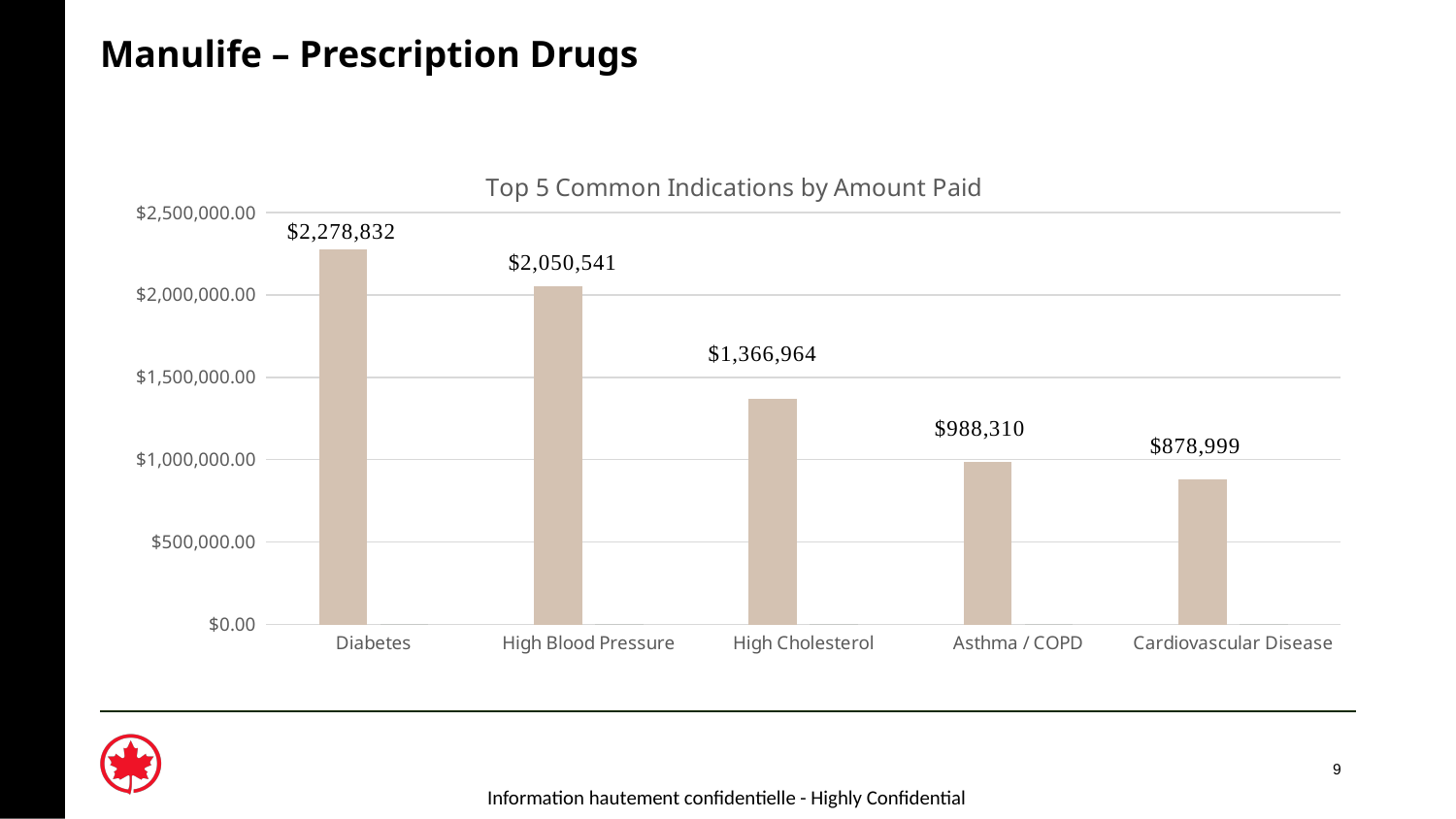
Which has a larger amount paid, High Blood Pressure or High Cholesterol? High Blood Pressure How many indications are shown in the chart? 5 What is the difference in amount paid between Asthma / COPD and Cardiovascular Disease? $109,311 Which indication has the lowest amount paid? Cardiovascular Disease What is the amount paid for Cardiovascular Disease? $878,999 What is the title of the chart? Top 5 Common Indications by Amount Paid What is the amount paid for High Cholesterol? $1,366,964 What is the amount paid for Diabetes? $2,278,832 Is the value for Asthma / COPD greater or less than $1,000,000.00? less What kind of chart is shown on the slide? Bar chart Which indication has the highest amount paid? Diabetes What is the difference in amount paid between Diabetes and High Blood Pressure? $228,291